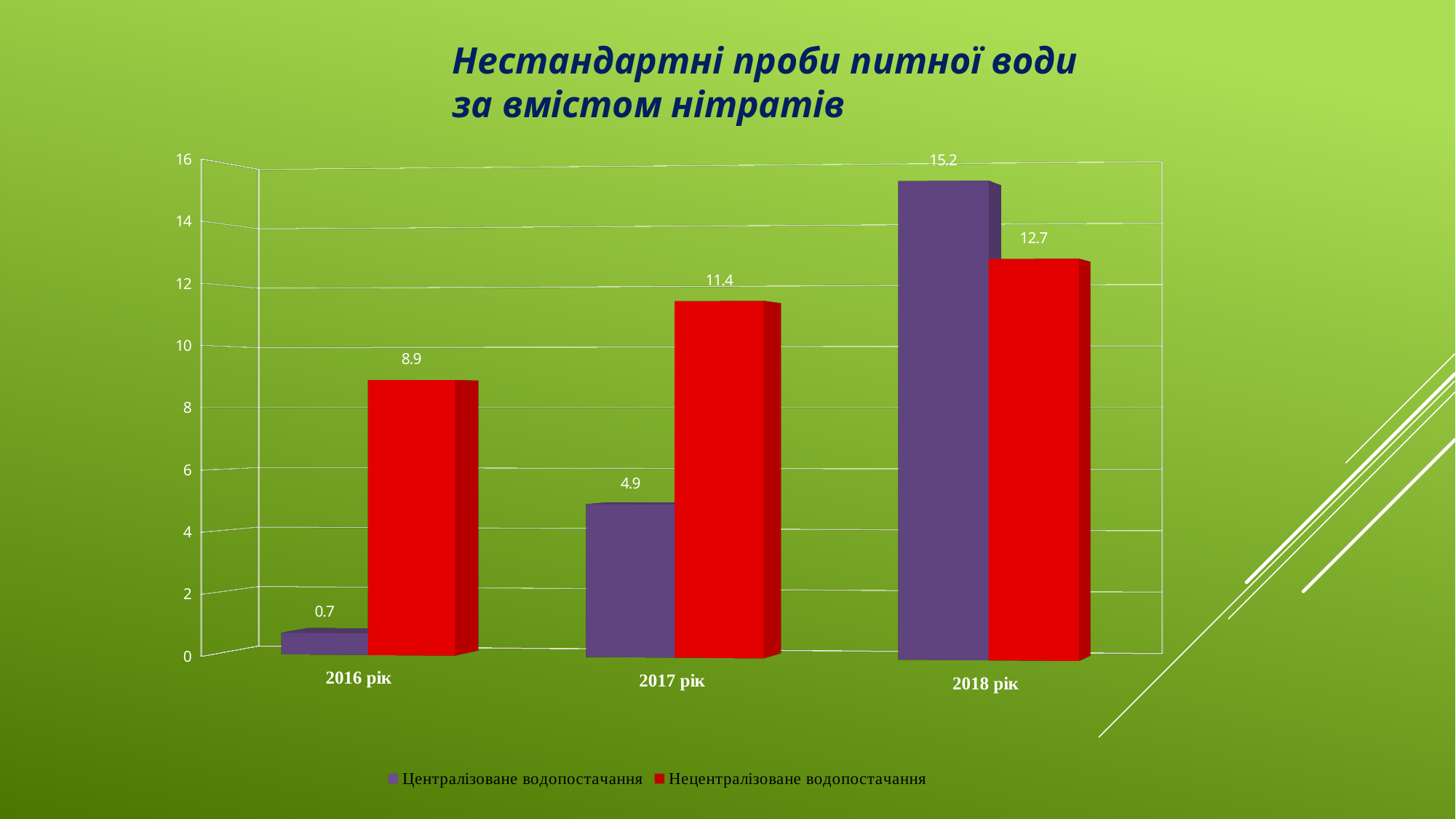
What kind of chart is shown on the slide? Bar chart What is the value for Централізоване водопостачання in 2018 рік? 15.2 Do the values for Централізоване водопостачання rise or fall from 2016 рік to 2018 рік? Rise How many years (categories) are shown on the x axis? 3 What is the difference between Нецентралізоване водопостачання and Централізоване водопостачання in 2016 рік? 8.2 In 2018 рік, which series has the larger value: Централізоване водопостачання or Нецентралізоване водопостачання? Централізоване водопостачання What is the value for Нецентралізоване водопостачання in 2017 рік? 11.4 How many series does the legend list? 2 What is the value for Централізоване водопостачання in 2016 рік? 0.7 Which year has the highest value for Нецентралізоване водопостачання? 2018 рік What colour are the bars for Нецентралізоване водопостачання? Red Which year has the lowest value for Централізоване водопостачання? 2016 рік